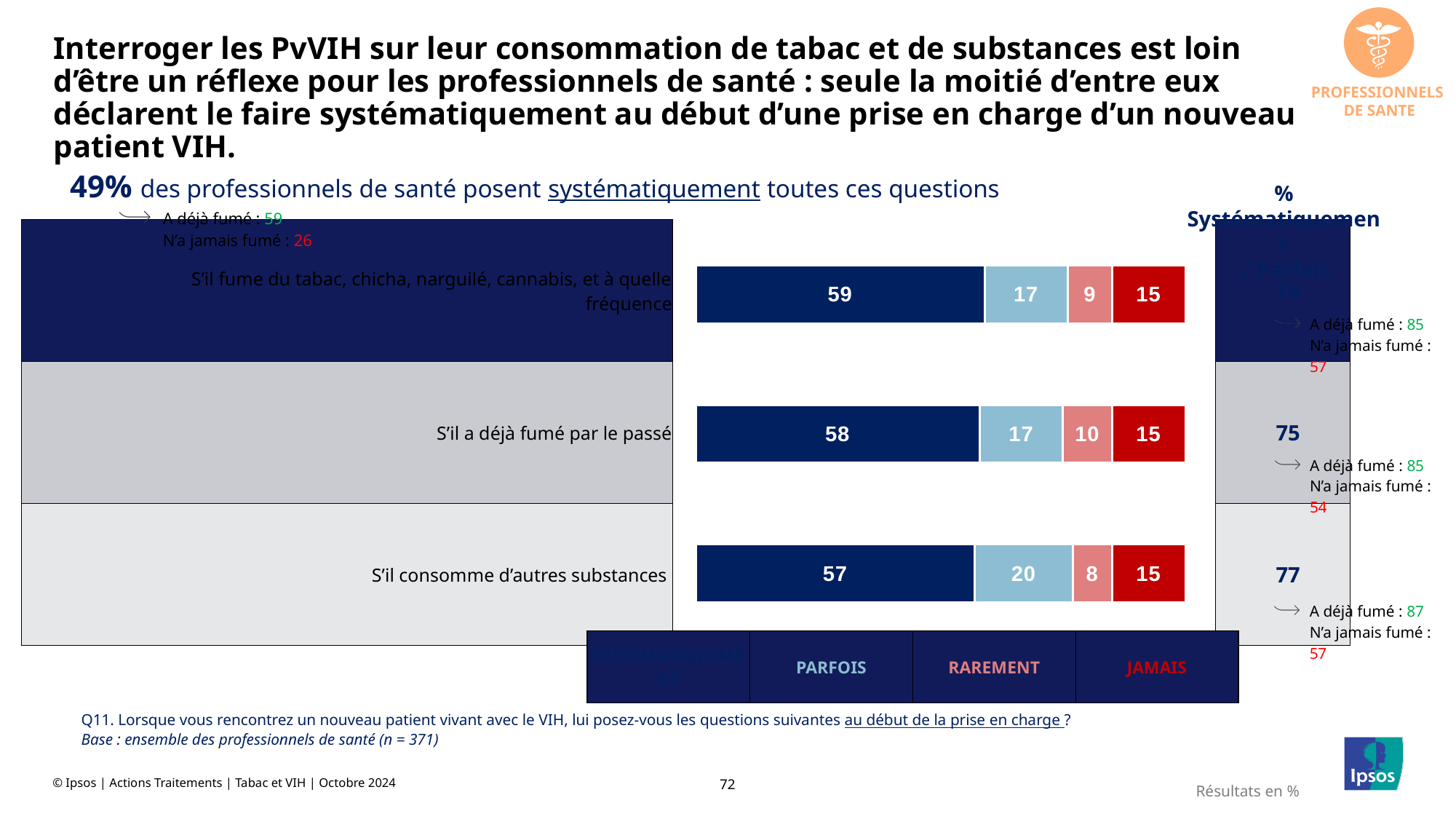
What type of chart is shown on the slide? Stacked bar chart What is the 'Jamais' value for 'S'il a déjà fumé par le passé'? 15 What is the total of the stacked bar for 'S'il consomme d'autres substances'? 100 How many series does the legend list? 4 Which category has the highest 'Systématiquement' value? S'il fume du tabac, chicha, narguilé, cannabis, et à quelle fréquence Which is larger: the 'Rarement' value for 'S'il a déjà fumé par le passé' or for 'S'il consomme d'autres substances'? S'il a déjà fumé par le passé What is the 'Parfois' value for 'S'il consomme d'autres substances'? 20 How many categories are shown in the chart? 3 Which category has the lowest 'Rarement' value? S'il consomme d'autres substances What is the 'Rarement' value for 'S'il fume du tabac, chicha, narguilé, cannabis, et à quelle fréquence'? 9 What is the 'Systématiquement' value for 'S'il a déjà fumé par le passé'? 58 What is the difference between the 'Parfois' values for 'S'il consomme d'autres substances' and 'S'il a déjà fumé par le passé'? 3